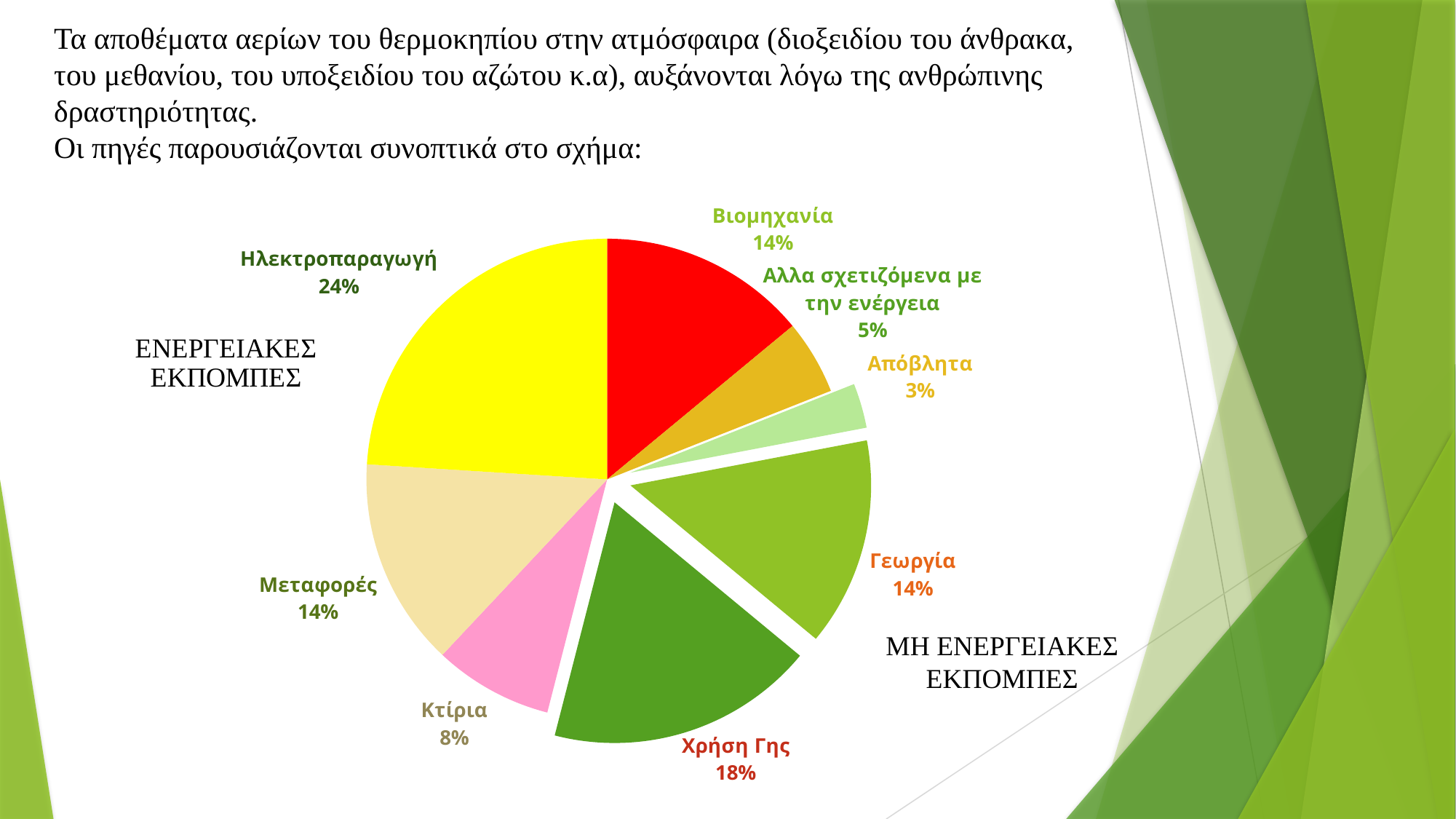
Which category has the smallest slice of the pie? Απόβλητα How many slices does the pie chart have? 8 What percentage is shown for Χρήση Γης? 18% What percentage of the pie is labelled Ηλεκτροπαραγωγή? 24% Which is larger, the slice for Χρήση Γης or the slice for Γεωργία? Χρήση Γης What type of chart is shown on the slide? pie chart What percentage is shown for Κτίρια? 8% What percentage is shown for Άλλα σχετιζόμενα με την ενέργεια? 5% What are the two group labels placed beside the pie chart? ΕΝΕΡΓΕΙΑΚΕΣ ΕΚΠΟΜΠΕΣ and ΜΗ ΕΝΕΡΓΕΙΑΚΕΣ ΕΚΠΟΜΠΕΣ What percentage is shown for Απόβλητα? 3% What is the difference in percentage points between Ηλεκτροπαραγωγή and Χρήση Γης? 6 Which category has the largest slice of the pie? Ηλεκτροπαραγωγή